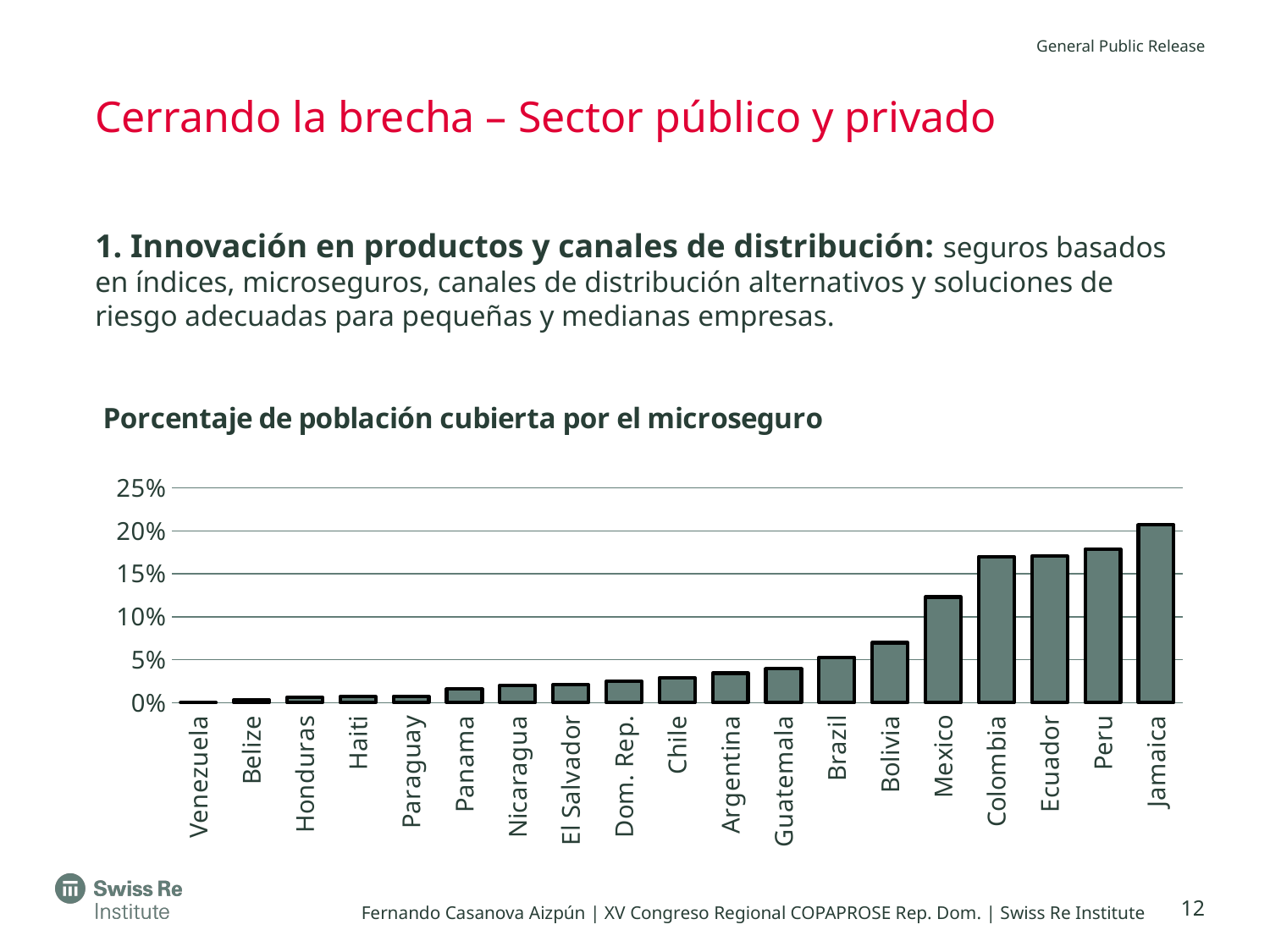
Which has a larger value, Chile or Brazil? Brazil Which has a larger value, Mexico or Bolivia? Mexico Is the value for Peru greater or less than 20%? less Is the value for Guatemala greater or less than 5%? less How many countries are shown on the x axis of the chart? 19 What kind of chart is shown on the slide? bar chart What is the title of the chart? Porcentaje de población cubierta por el microseguro Is the value for Jamaica greater or less than 15%? greater Do the values rise or fall moving from left to right along the x axis? rise Which country has the lowest percentage of population covered by microinsurance? Venezuela Which country has the highest percentage of population covered by microinsurance? Jamaica